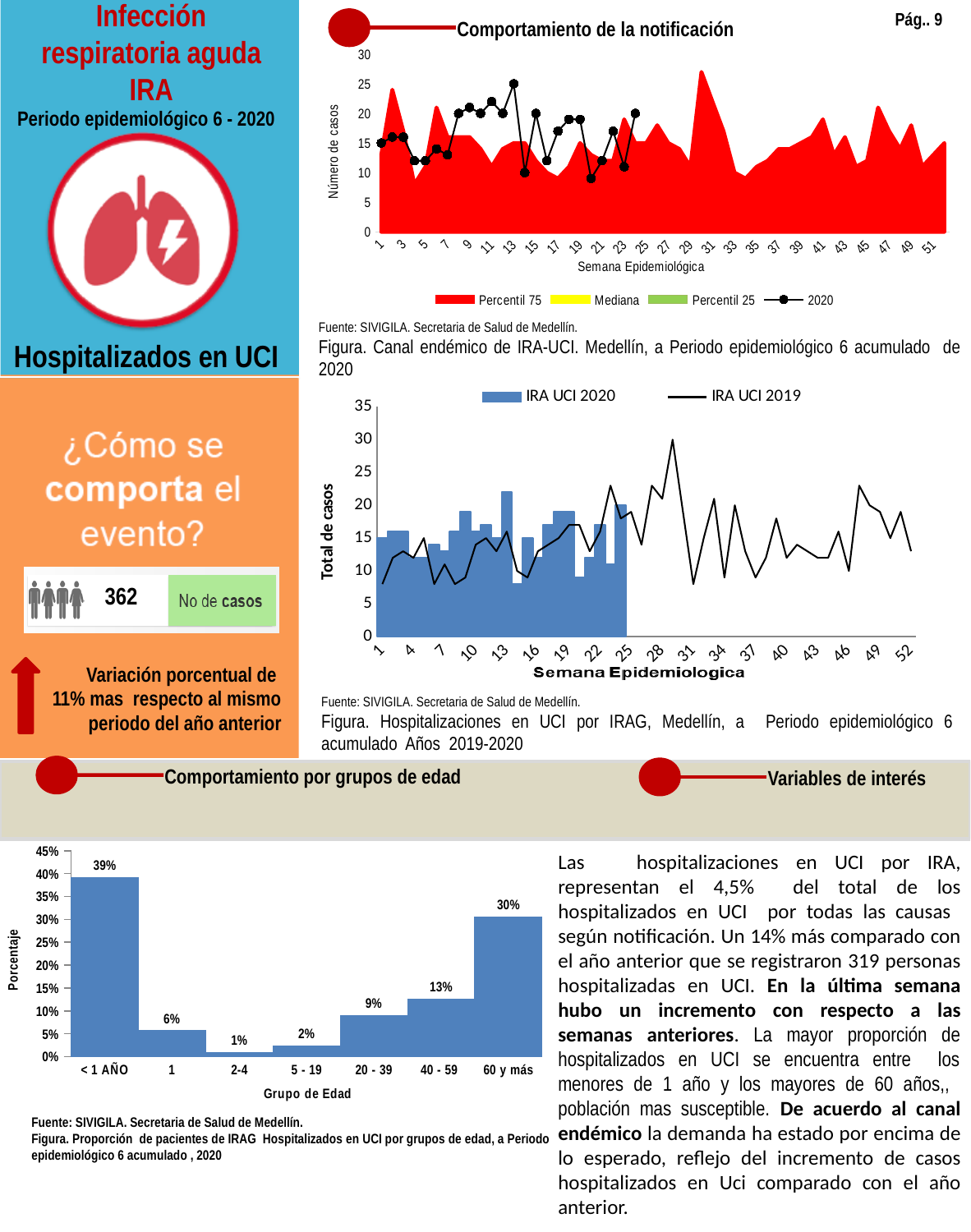
In the bar chart 'Proporción de pacientes de IRAG Hospitalizados en UCI por grupos de edad', what is the value for the '< 1 AÑO' group? 39% In the bar chart by age group (bottom left), which age group has the lowest percentage? 2-4 In the 'Hospitalizaciones en UCI por IRAG' chart (middle right), is the IRA UCI 2020 value at week 13 greater or less than 20? greater In the bar chart by age group (bottom left), what is the value for the '40 - 59' group? 13% What kind of chart is the 'Proporción de pacientes de IRAG Hospitalizados en UCI por grupos de edad' chart at the bottom left? bar chart In the bar chart by age group (bottom left), which age group has the highest percentage? < 1 AÑO In the bar chart by age group (bottom left), which is larger: the value for '20 - 39' or the value for '40 - 59'? 40 - 59 In the bar chart by age group (bottom left), what is the difference between the '< 1 AÑO' value and the '60 y más' value? 9% In the 'Hospitalizaciones en UCI por IRAG' chart (middle right), how many series does the legend list? 2 In the bar chart by age group (bottom left), what is the value for the '60 y más' group? 30% How many series does the legend list in the 'Comportamiento de la notificación' chart (top right)? 4 How many age groups are shown in the bar chart by age group (bottom left)? 7